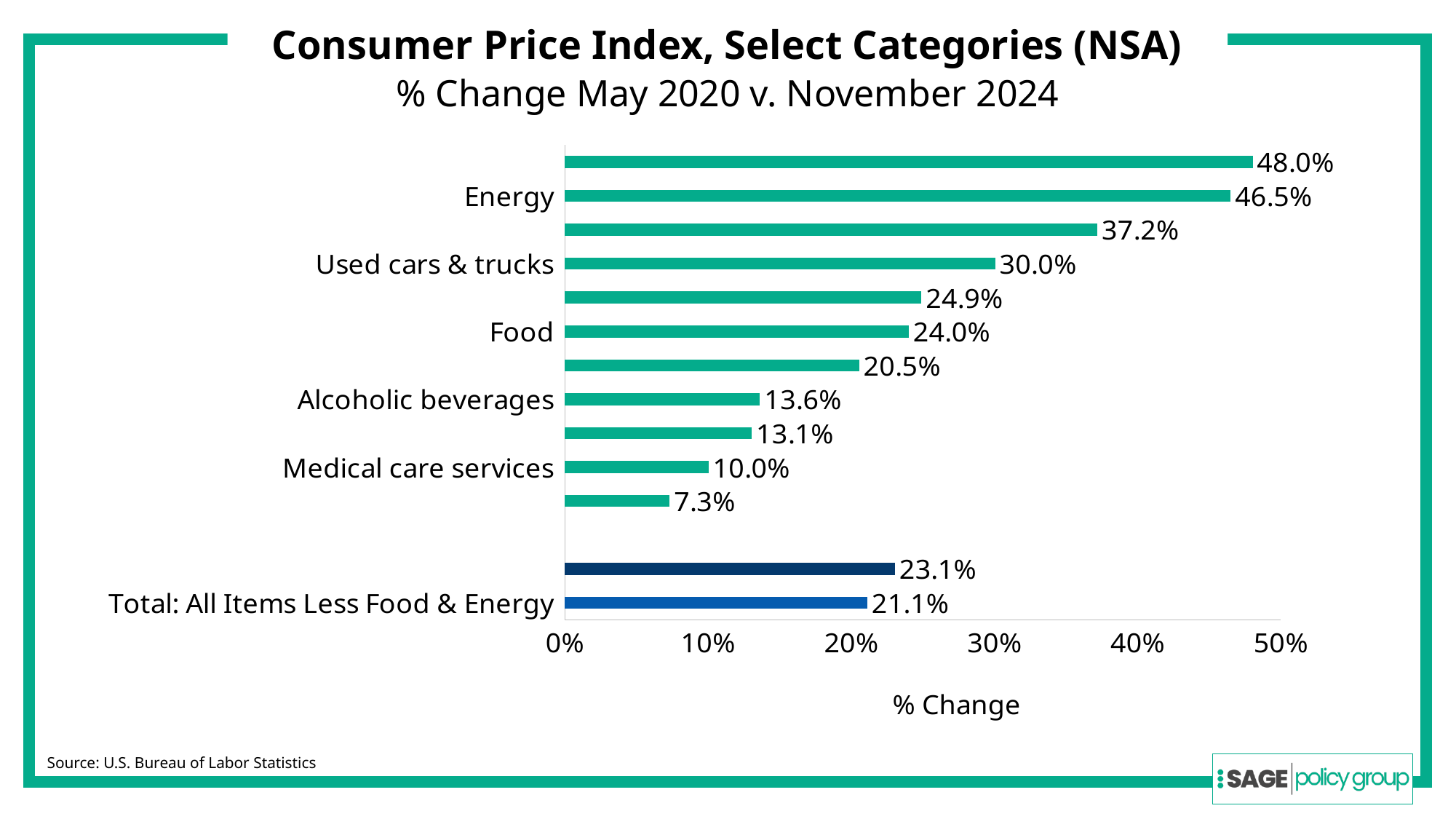
What is the % change for Medical care services? 10.0% What is the largest % change value shown on the chart? 48.0% What is the % change for Used cars & trucks? 30.0% What is the difference in % change between Energy and Food? 22.5 percentage points What is the smallest % change value shown on the chart? 7.3% What is the % change for Alcoholic beverages? 13.6% What is the % change for Food? 24.0% What is the % change for Total: All Items Less Food & Energy? 21.1% Which has a larger % change, Used cars & trucks or Food? Used cars & trucks How many bars are plotted on the chart? 13 What type of chart is shown on the slide? Bar chart What is the % change for Energy? 46.5%